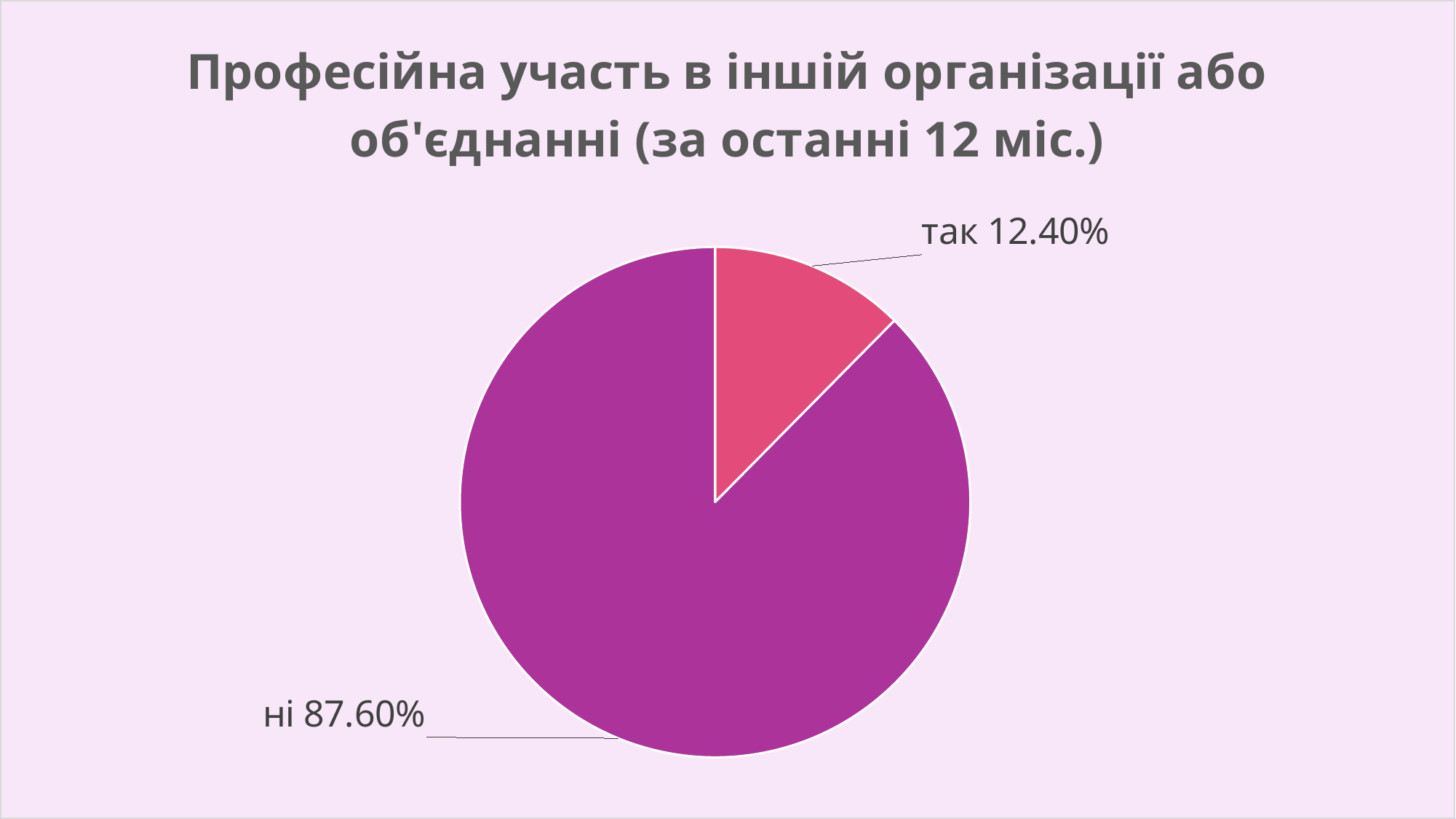
Which category has the largest share of the pie? ні Which is larger, the value for "так" or the value for "ні"? ні What is the value for "так"? 12.40% What is the title of the chart? Професійна участь в іншій організації або об'єднанні (за останні 12 міс.) What colour is the "так" slice? pink What is the difference between the values for "ні" and "так"? 75.20% What kind of chart is shown on the slide? pie chart How many slices does the pie chart have? 2 Which category has the smallest share of the pie? так What share of the pie does the "так" slice represent? 12.40% What is the value for "ні"? 87.60%